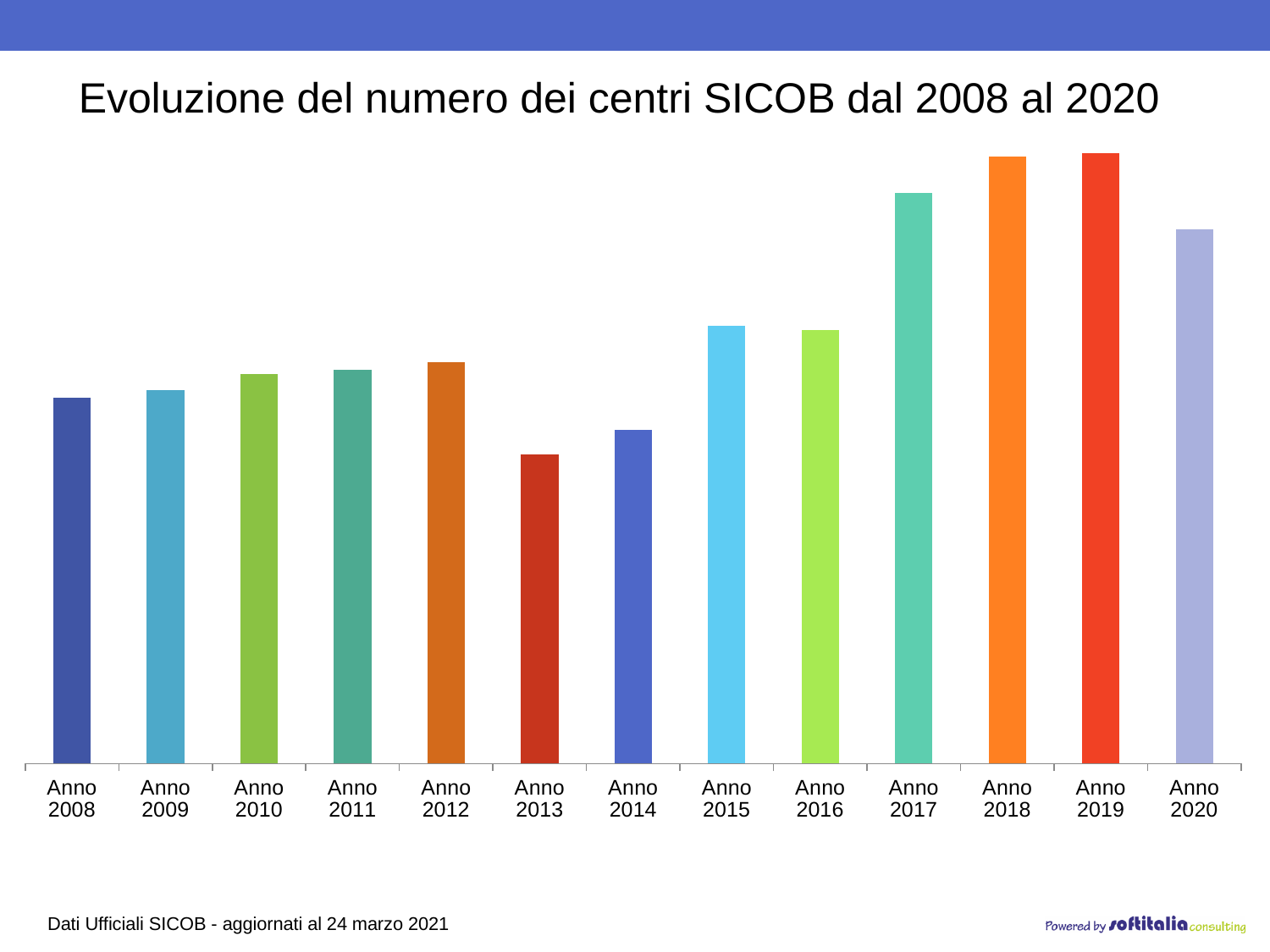
Which is larger, the value for Anno 2013 or the value for Anno 2014? Anno 2014 Which year has the lowest bar on the chart? Anno 2013 Do the values rise or fall from Anno 2019 to Anno 2020? fall Which is larger, the value for Anno 2017 or the value for Anno 2020? Anno 2017 What is the title of the chart? Evoluzione del numero dei centri SICOB dal 2008 al 2020 What kind of chart is shown on the slide? bar chart Which is larger, the value for Anno 2018 or the value for Anno 2020? Anno 2018 What is the data source note shown at the bottom of the slide? Dati Ufficiali SICOB - aggiornati al 24 marzo 2021 Do the values rise or fall from Anno 2008 to Anno 2012? rise How many years (categories) are plotted on the chart? 13